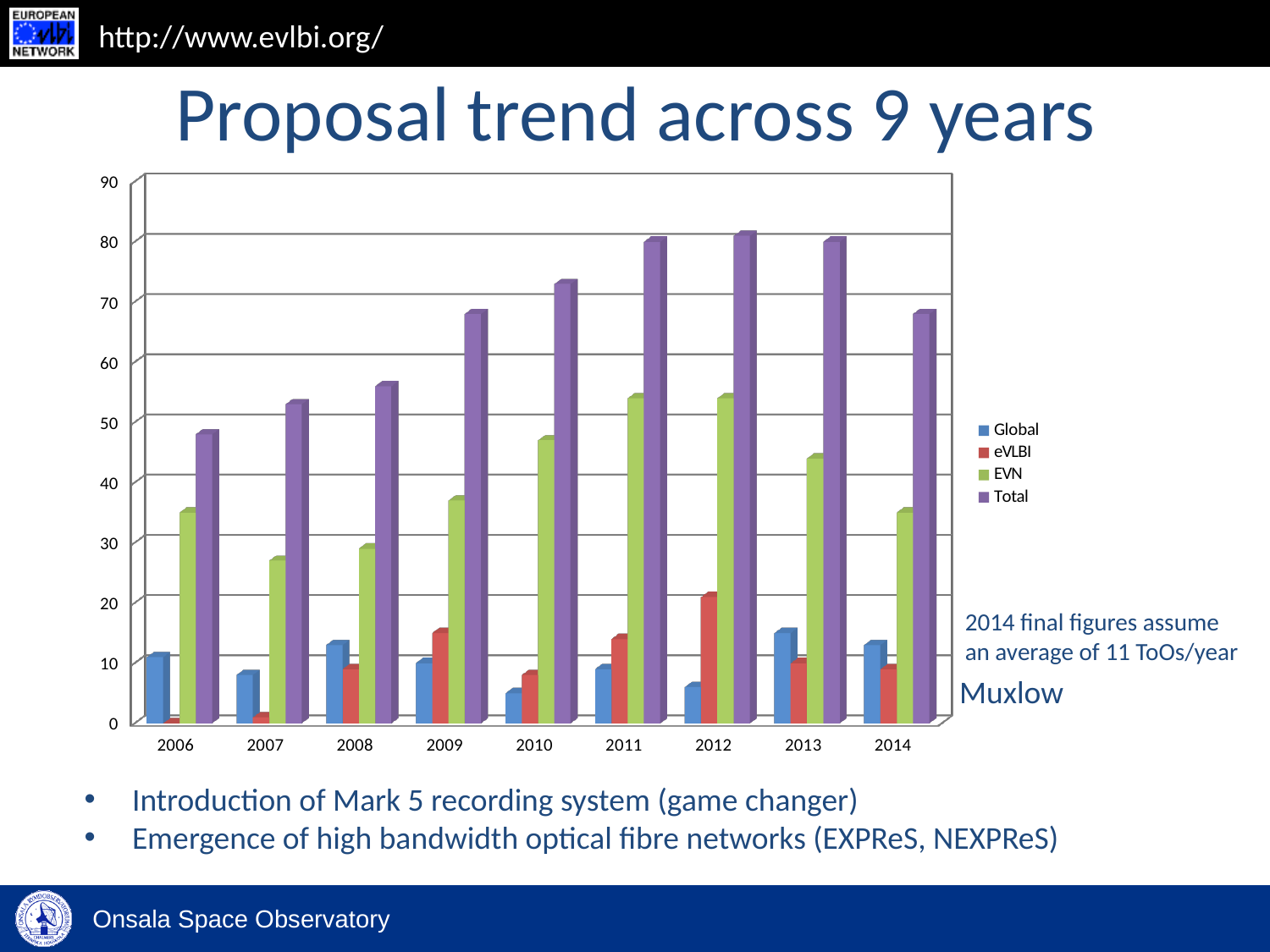
Does the Total value rise or fall from 2006 to 2012? rise Is the Total value for 2006 greater or less than 50? less Which series is shown in purple in the chart legend? Total What kind of chart is shown on the slide? bar chart How many years are shown along the x axis of the chart? 9 How many series does the chart legend list? 4 Which is larger, the EVN value for 2012 or the EVN value for 2013? 2012 In which year is the Global value highest? 2013 Is the Total value for 2010 greater or less than 70? greater What is the title of the chart? Proposal trend across 9 years Is the EVN value for 2014 greater or less than 40? less In which year is the eVLBI value highest? 2012